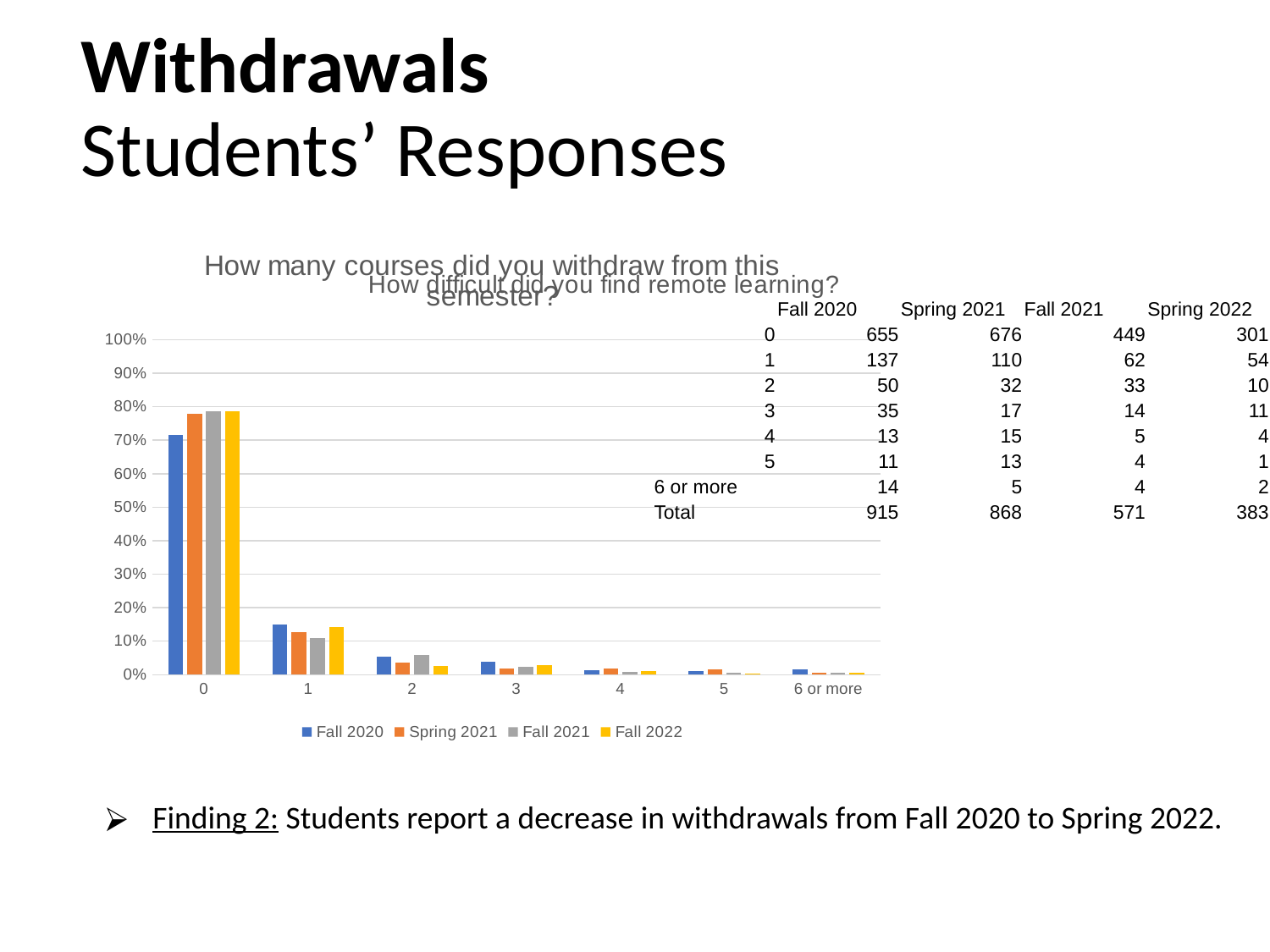
Is the Fall 2020 value for category 0 greater or less than 80%? less Do the bar values generally rise or fall moving from category 0 to category 6 or more? fall For category 0, which series has the lowest bar? Fall 2020 How many categories are shown along the x axis of the chart? 7 For category 0, which is larger: the Fall 2020 bar or the Spring 2021 bar? Spring 2021 Is the Fall 2020 value for category 0 greater or less than 60%? greater Is the Fall 2020 value for category 1 greater or less than 10%? greater What kind of chart is shown on the slide? bar chart How many series does the chart's legend list? 4 For category 2, which is larger: the Fall 2020 bar or the Fall 2022 bar? Fall 2020 Which category on the x axis has the tallest bars? 0